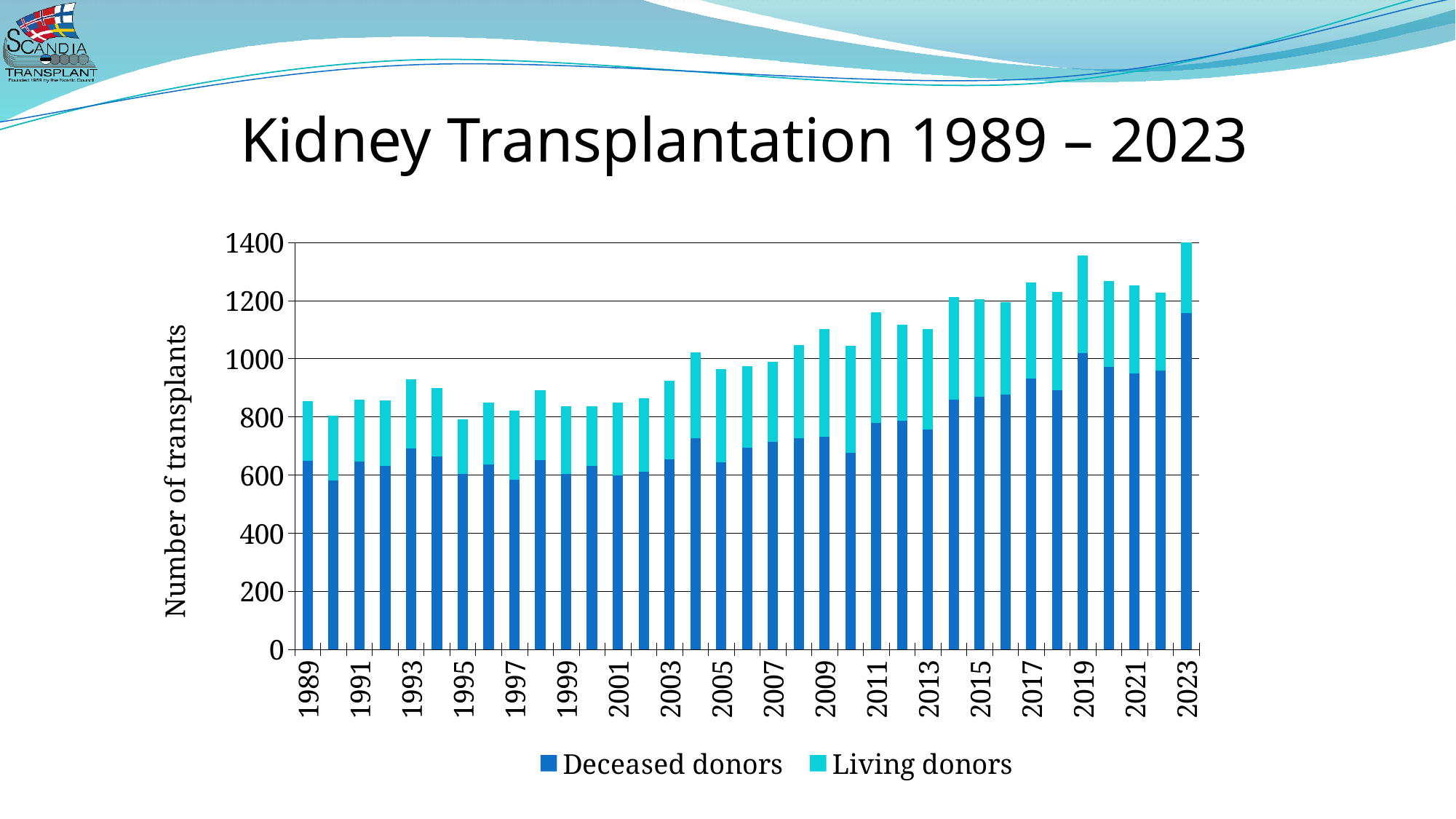
Is the number of deceased donor transplants in 1989 greater or less than 800? less What are the two series named in the legend? Deceased donors and Living donors Which year has the larger total number of transplants, 2009 or 2019? 2019 Which year has the highest total number of transplants? 2023 How many series does the legend list? 2 How many years (bars) are plotted in the chart? 35 Is the total number of transplants in 2023 greater or less than 1200? greater Is the number of deceased donor transplants in 2023 greater or less than 1000? greater Overall, does the total number of transplants rise or fall from 1989 to 2023? rise What is the title of the chart? Kidney Transplantation 1989 – 2023 What kind of chart is shown on the slide? Stacked bar chart